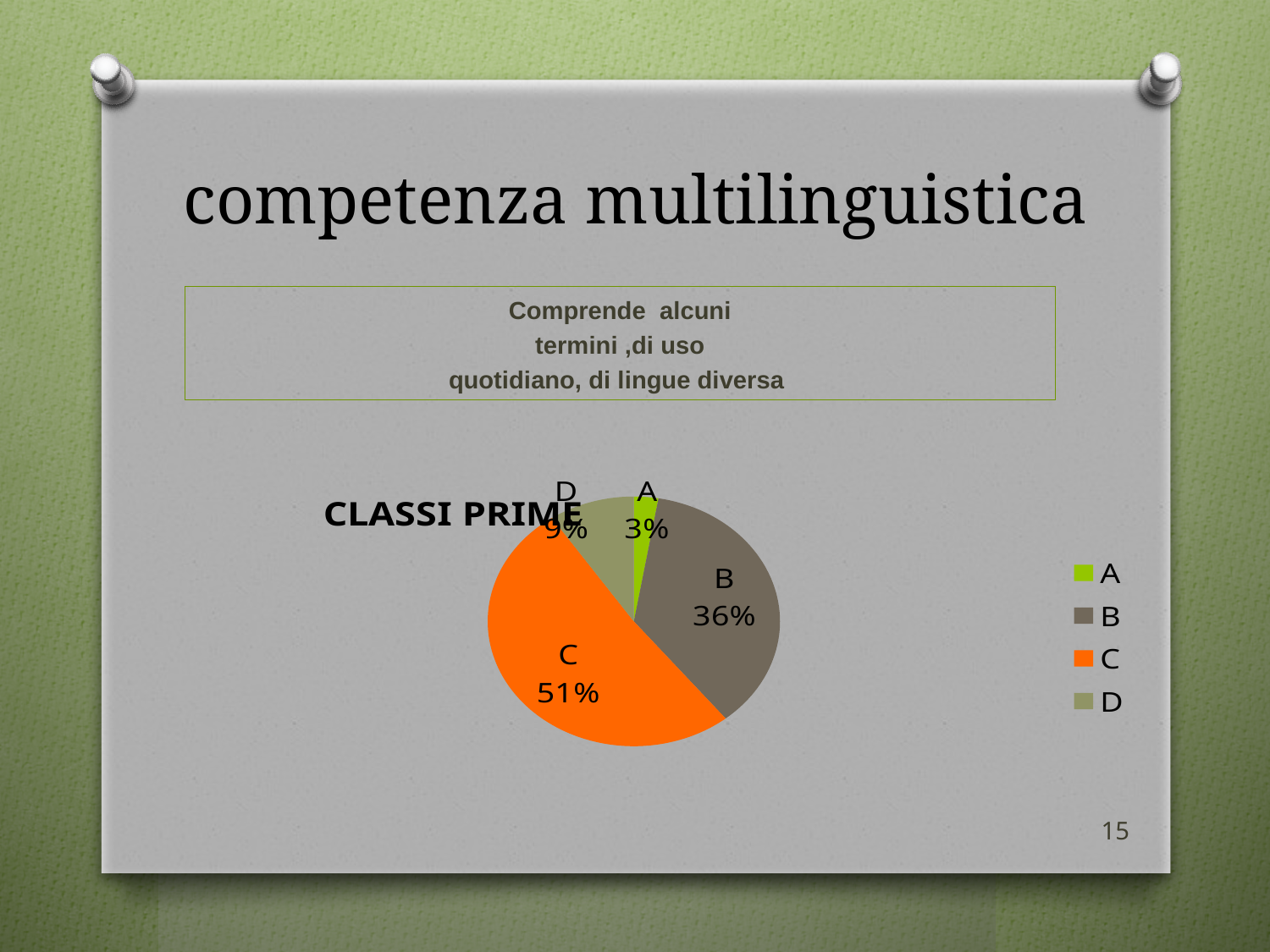
What percentage does slice B represent? 36% Which category has the smallest share of the pie? A Which category has the largest share of the pie? C What percentage does slice A represent? 3% What colour is the slice for category C? orange Which is larger, the share for D or the share for A? D What is the title of the chart? CLASSI PRIME What kind of chart is shown on the slide? pie chart What is the difference in percentage points between C and B? 15 How many categories does the legend list? 4 What percentage does slice D represent? 9% What percentage does slice C represent? 51%